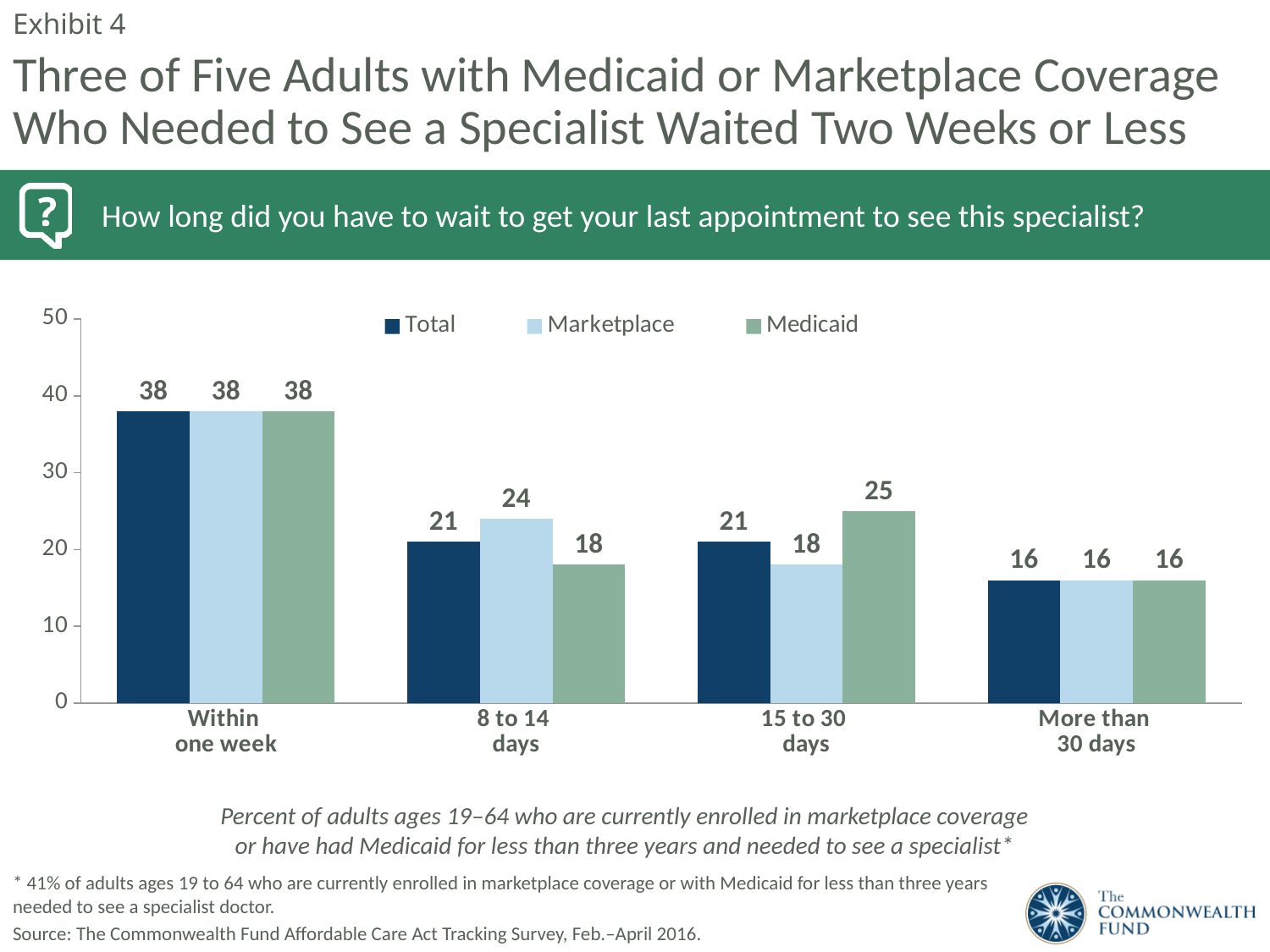
What is the Total value for 'Within one week'? 38 What are the three series listed in the legend? Total, Marketplace, Medicaid What is the difference between the Marketplace and Medicaid values for '8 to 14 days'? 6 Which category has the lowest Medicaid value? More than 30 days How many categories are shown on the x axis? 4 What is the Medicaid value for '15 to 30 days'? 25 What kind of chart is shown on the slide? Bar chart What is the Marketplace value for '8 to 14 days'? 24 Which category has the highest Total value? Within one week For '15 to 30 days', which is larger: the Marketplace value or the Medicaid value? Medicaid How many series does the legend list? 3 Do the Total values rise or fall from 'Within one week' to 'More than 30 days'? Fall